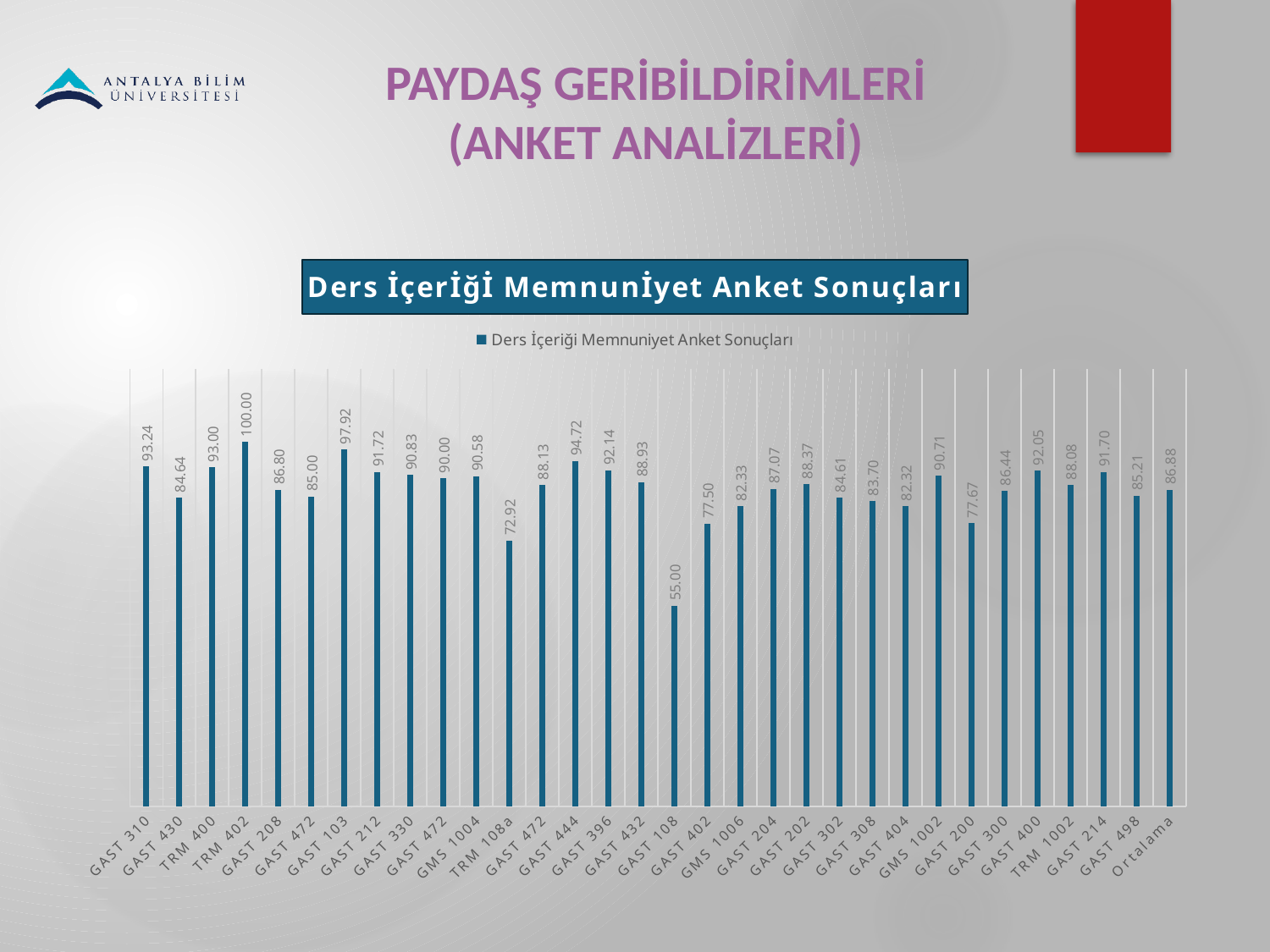
Which is larger, the value for GAST 103 or the value for GAST 400? GAST 103 What is the value for GAST 444? 94.72 How many bars are plotted in the chart? 32 Which category has the lowest value? GAST 108 What is the value for Ortalama? 86.88 What is the value for GAST 108? 55.00 What is the difference between the values for TRM 402 and GAST 108? 45.00 What kind of chart is shown? Bar chart What is the legend entry of the chart? Ders İçeriği Memnuniyet Anket Sonuçları Which category has the highest value? TRM 402 What is the value for TRM 402? 100.00 What is the difference between the values for GAST 310 and GAST 430? 8.60